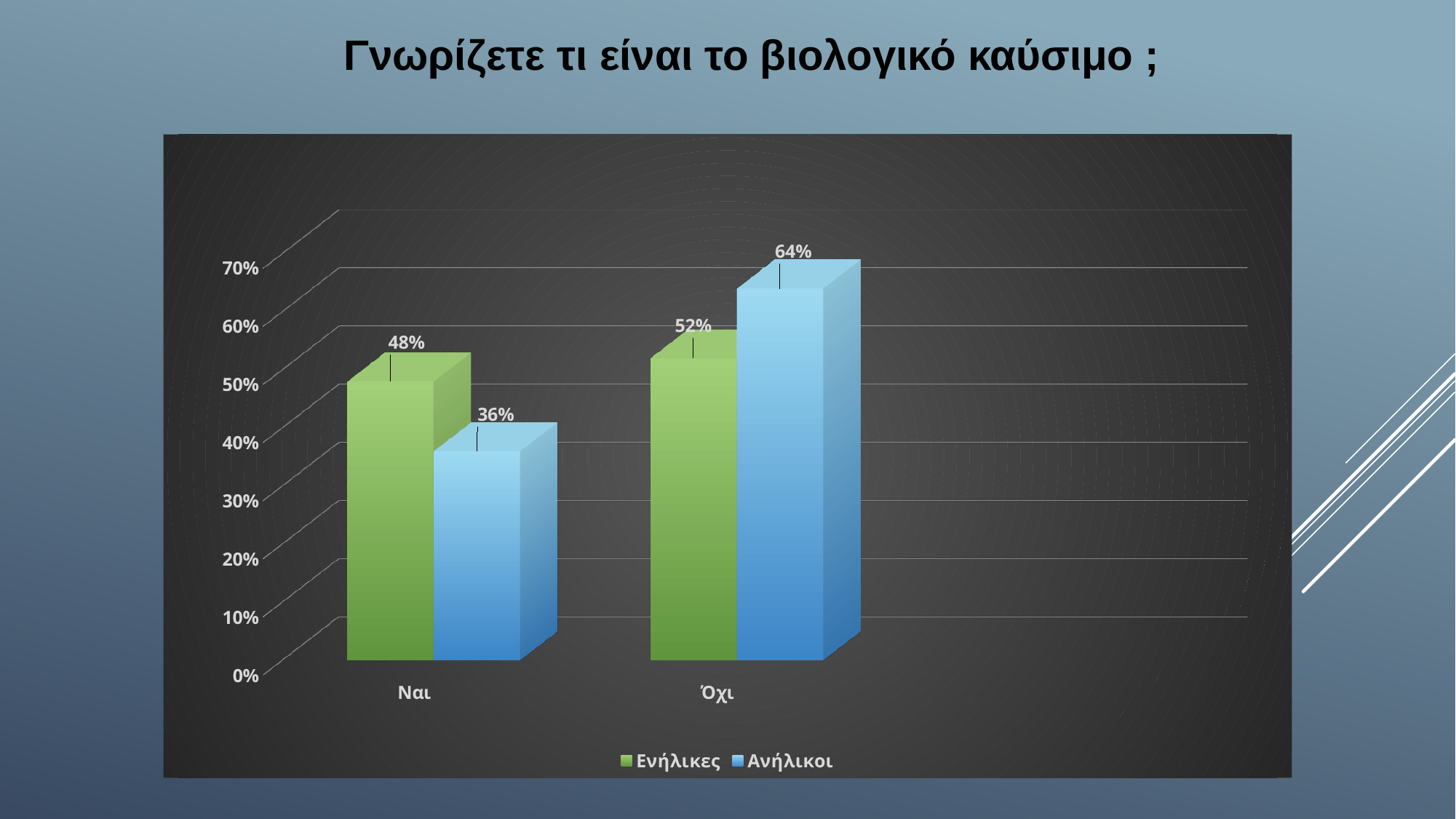
Which category has the lowest value for Ενήλικες? Ναι What is the value for Ενήλικες in the Όχι category? 52% What kind of chart is shown on the slide? Bar chart What is the difference between the Ανήλικοι values for Όχι and Ναι? 28% What is the difference between the Ενήλικες and Ανήλικοι values in the Ναι category? 12% What is the value for Ανήλικοι in the Όχι category? 64% Which category has the highest value for Ανήλικοι? Όχι What is the value for Ανήλικοι in the Ναι category? 36% In the Όχι category, which series has the larger value, Ενήλικες or Ανήλικοι? Ανήλικοι What is the value for Ενήλικες in the Ναι category? 48% How many categories are shown on the x axis? 2 How many series does the legend list? 2